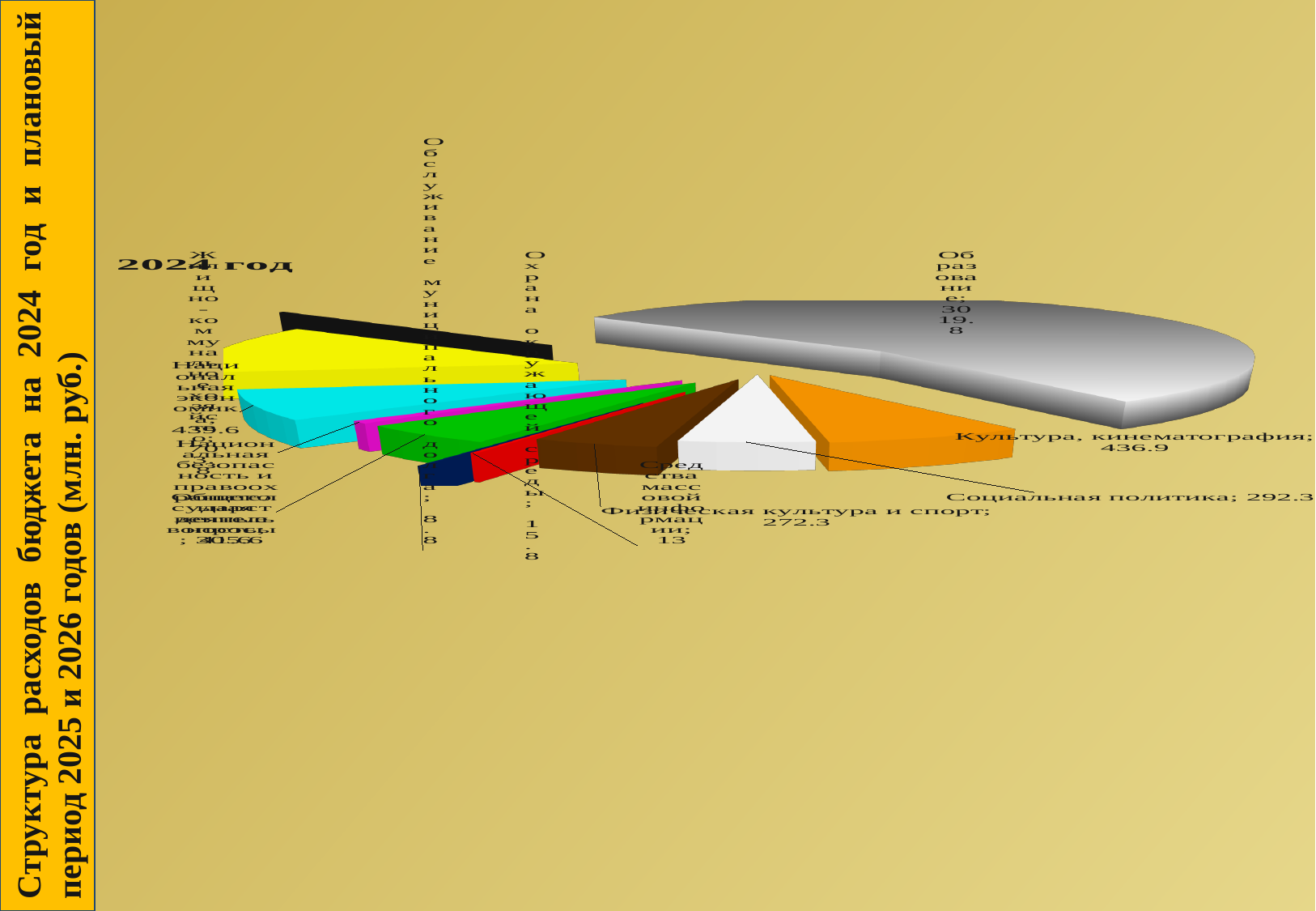
What is the value for Социальная политика? 292.3 What is the value for Обслуживание муниципального долга? 8.8 What is the value for Образование in the pie chart? 3019.8 What is the title of the pie chart? 2024 год What is the value for Средства массовой информации? 13 What kind of chart is shown on the slide? pie chart What is the difference between Социальная политика and Физическая культура и спорт? 20 Which is larger: Культура, кинематография or Социальная политика? Культура, кинематография What is the value for Охрана окружающей среды? 15.8 What is the value for Культура, кинематография? 436.9 Which category has the largest slice in the pie chart? Образование What is the value for Физическая культура и спорт? 272.3